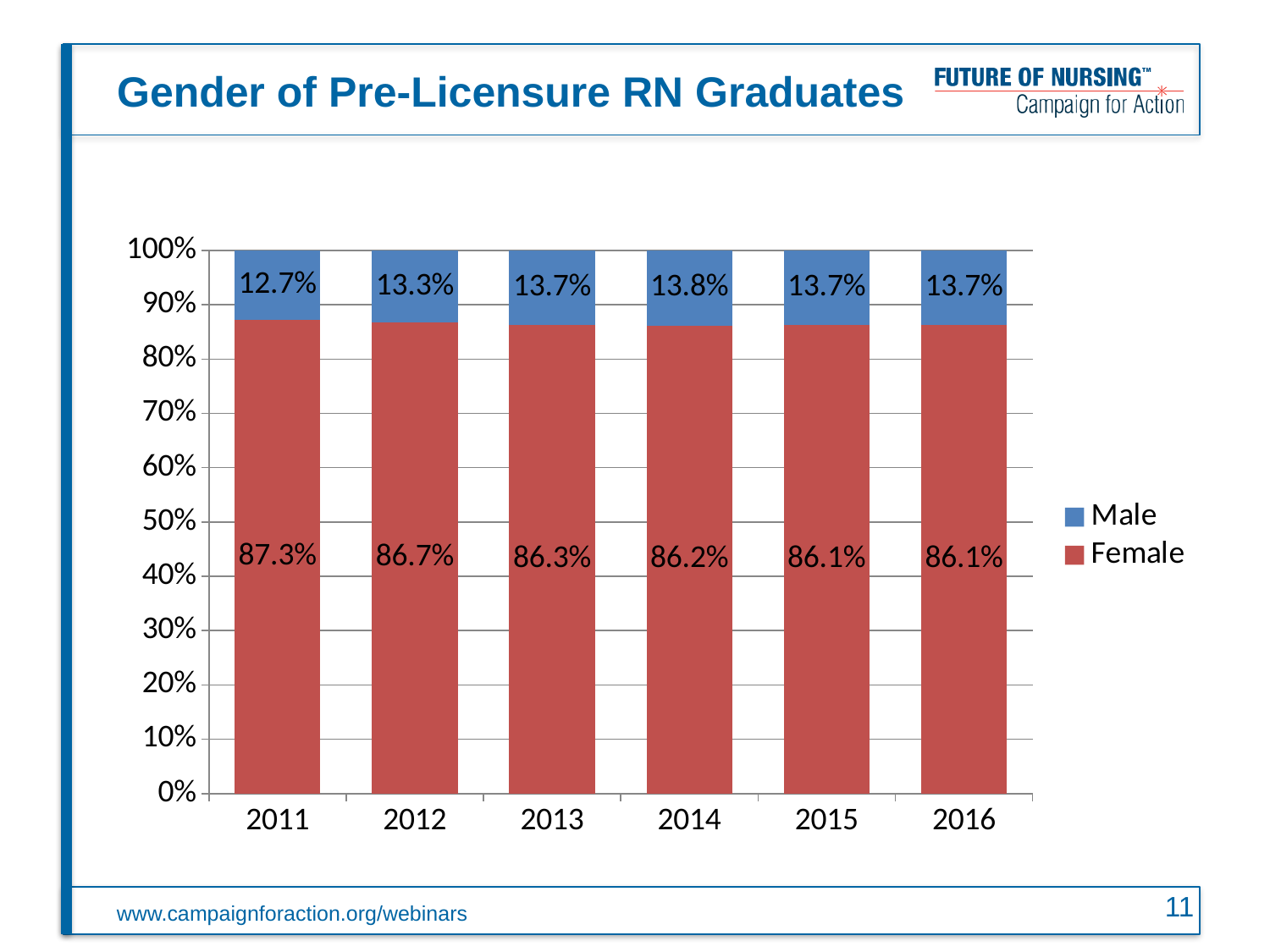
What is the difference between the Female share in 2011 and the Female share in 2016? 1.2% How many years are shown on the x axis? 6 Which is larger, the Male share in 2012 or the Male share in 2013? 2013 In which year was the Male share lowest? 2011 Does the Female share generally rise or fall from 2011 to 2016? Fall In which year was the Female share highest? 2011 What percentage of pre-licensure RN graduates were male in 2014? 13.8% What kind of chart is shown on the slide? Stacked bar chart What percentage of pre-licensure RN graduates were female in 2011? 87.3% How many series does the legend list? 2 What is the Female value for 2016? 86.1% In which year was the Male share highest? 2014